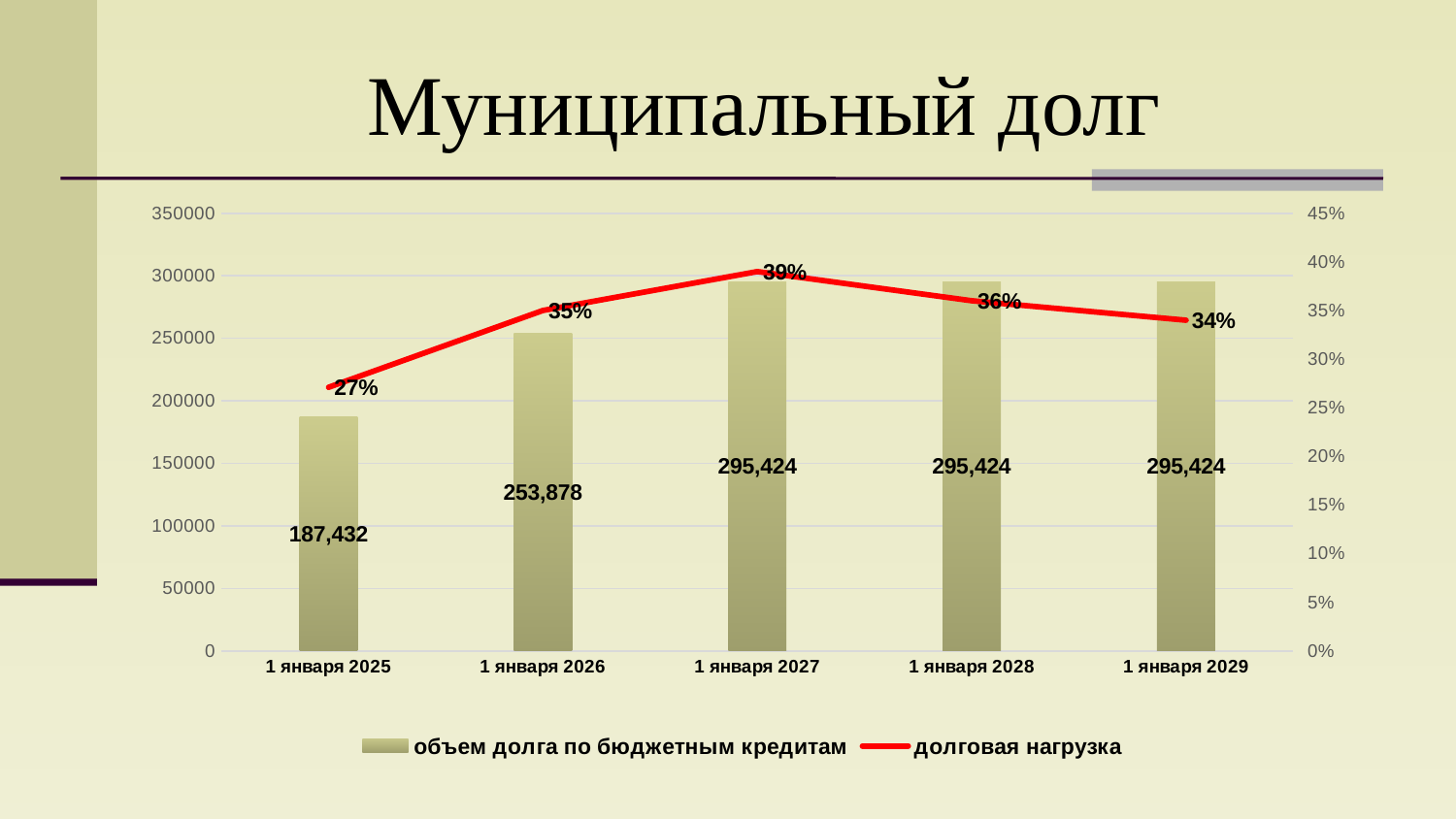
What is the value of объем долга по бюджетным кредитам for 1 января 2026? 253,878 Which date has the lowest объем долга по бюджетным кредитам? 1 января 2025 Which date has the highest долговая нагрузка? 1 января 2027 How many dates are shown on the x axis? 5 What is the долговая нагрузка value for 1 января 2027? 39% What is the долговая нагрузка value for 1 января 2029? 34% How many series does the legend list? 2 What is the value of объем долга по бюджетным кредитам for 1 января 2025? 187,432 What is the difference in объем долга по бюджетным кредитам between 1 января 2026 and 1 января 2025? 66,446 Which is larger, the долговая нагрузка for 1 января 2028 or for 1 января 2029? 1 января 2028 What is the title of the chart? Муниципальный долг What is the difference in долговая нагрузка between 1 января 2027 and 1 января 2025? 12%